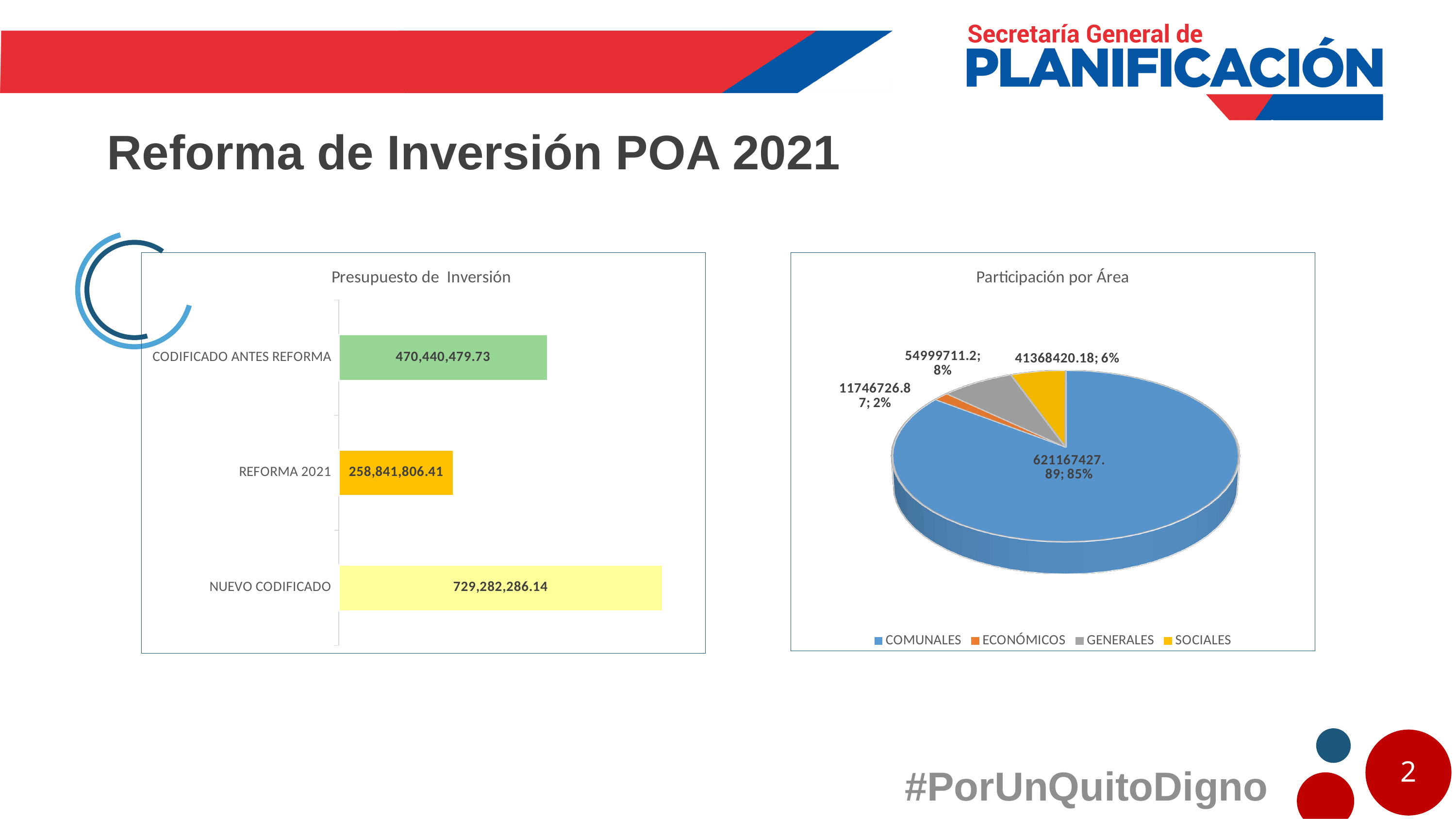
In the Participación por Área chart, what share of the pie does COMUNALES have? 85% In the Presupuesto de Inversión chart, how many categories are shown? 3 In the Presupuesto de Inversión chart, what is the difference between NUEVO CODIFICADO and CODIFICADO ANTES REFORMA? 258,841,806.41 What kind of chart is the Participación por Área chart? Pie chart In the Participación por Área chart, what is the value for GENERALES? 54999711.2 In the Participación por Área chart, which area has the smallest slice? ECONÓMICOS What kind of chart is the Presupuesto de Inversión chart? Bar chart In the Presupuesto de Inversión chart, which category has the lowest value? REFORMA 2021 In the Presupuesto de Inversión chart, what is the value for REFORMA 2021? 258,841,806.41 In the Participación por Área chart, how many entries does the legend list? 4 In the Presupuesto de Inversión chart, what is the value for CODIFICADO ANTES REFORMA? 470,440,479.73 In the Presupuesto de Inversión chart, which category has the highest value? NUEVO CODIFICADO